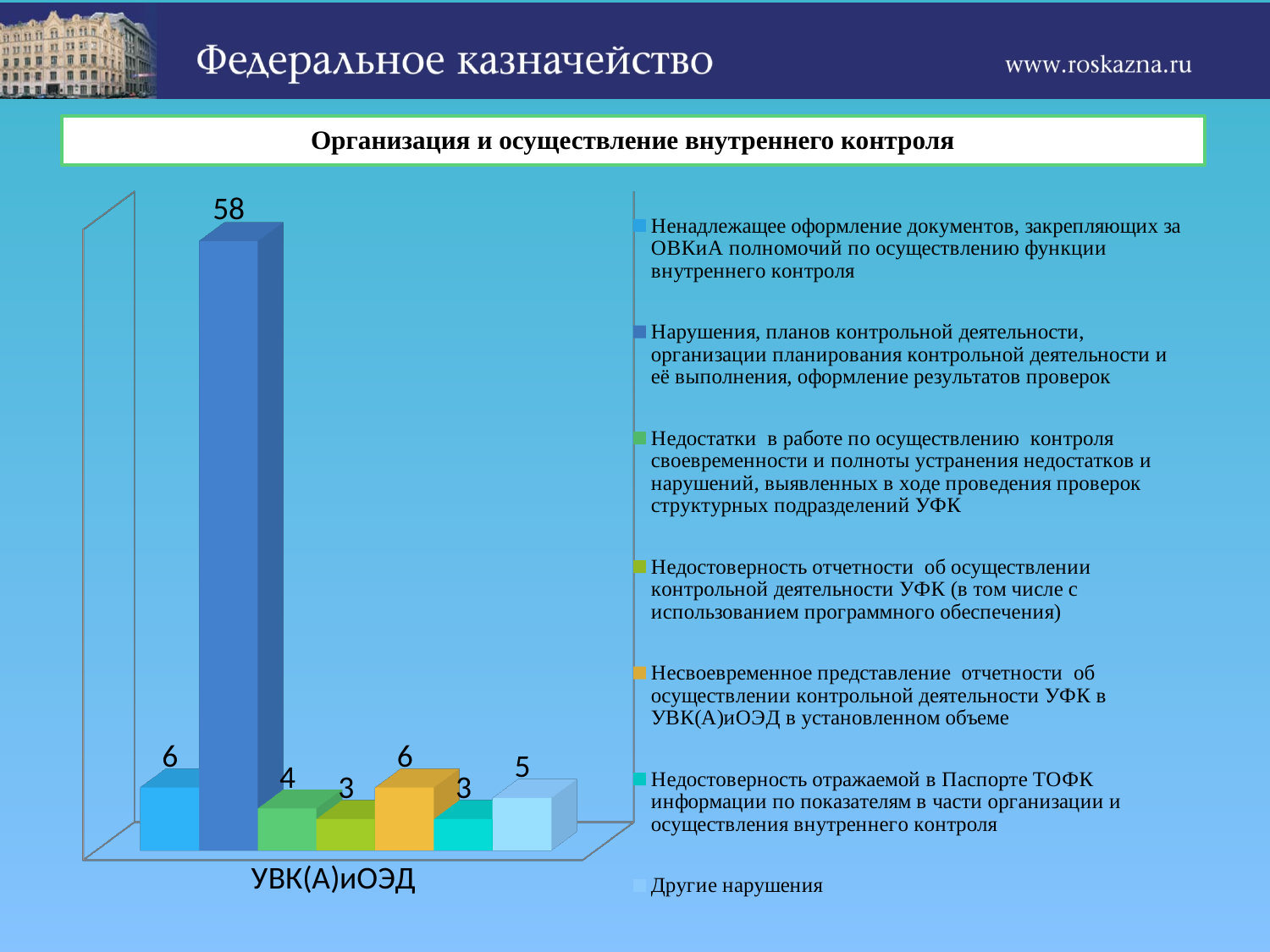
Which is larger: the value for "Другие нарушения" or the value for "Недостоверность отражаемой в Паспорте ТОФК информации по показателям в части организации и осуществления внутреннего контроля"? Другие нарушения What is the value for the series "Другие нарушения"? 5 How many bars are plotted in the chart? 7 What type of chart is shown on the slide? bar chart How many series does the legend list? 7 What is the value for the series "Нарушения, планов контрольной деятельности, организации планирования контрольной деятельности и её выполнения, оформление результатов проверок"? 58 What is the value for the series "Недостатки в работе по осуществлению контроля своевременности и полноты устранения недостатков и нарушений, выявленных в ходе проведения проверок структурных подразделений УФК"? 4 What is the title of the slide above the chart? Организация и осуществление внутреннего контроля Which series has the highest value? Нарушения, планов контрольной деятельности, организации планирования контрольной деятельности и её выполнения, оформление результатов проверок What is the value for the series "Несвоевременное представление отчетности об осуществлении контрольной деятельности УФК в УВК(А)иОЭД в установленном объеме"? 6 What is the difference between the highest bar (58) and the bar for "Другие нарушения" (5)? 53 What is the category label shown on the x axis? УВК(А)иОЭД